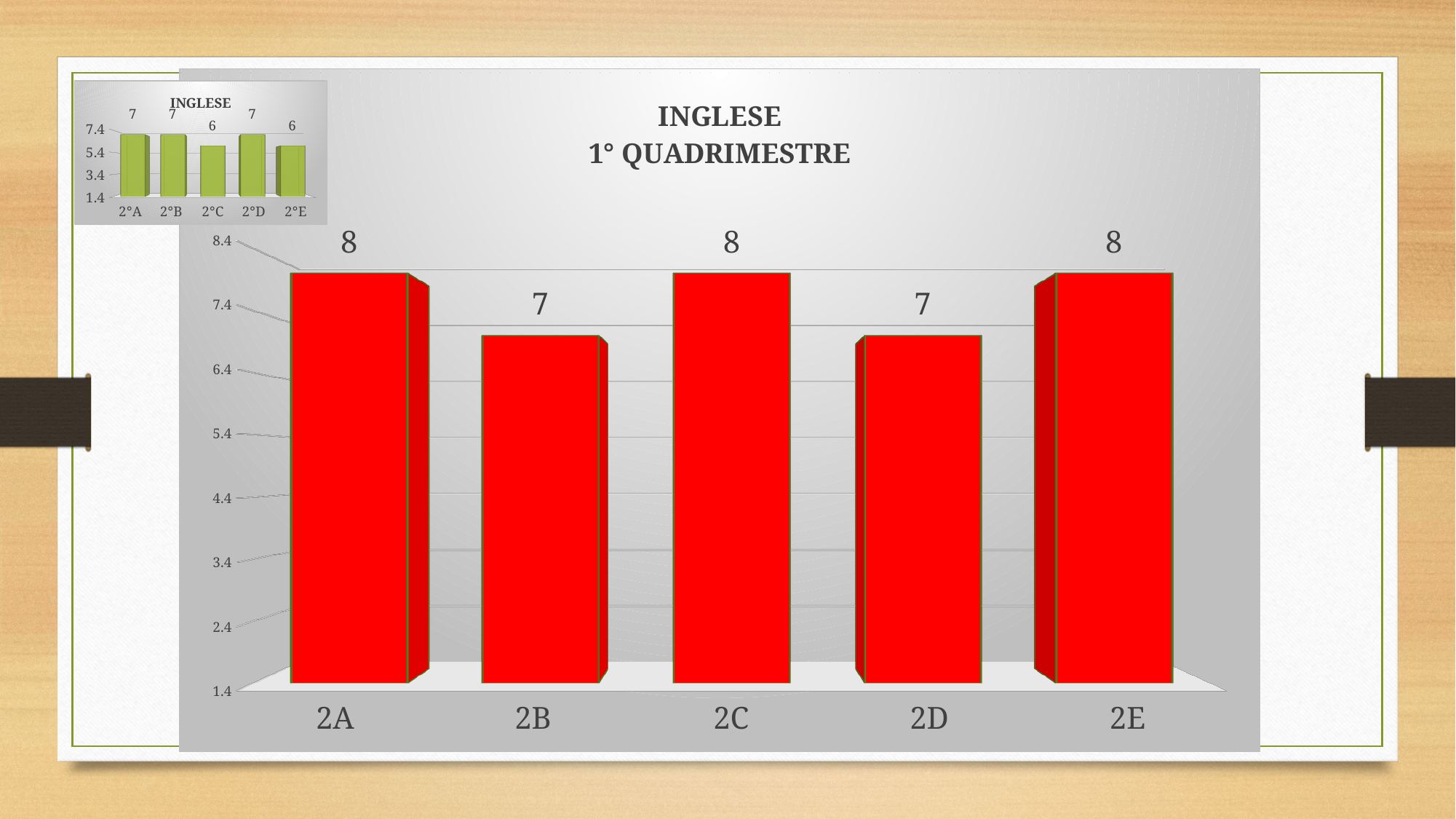
In the large chart titled INGLESE 1° QUADRIMESTRE, what is the value for 2E? 8 In the large chart titled INGLESE 1° QUADRIMESTRE, what is the value for 2D? 7 What kind of chart is the large chart titled INGLESE 1° QUADRIMESTRE? bar chart In the large chart titled INGLESE 1° QUADRIMESTRE, what is the value for 2B? 7 In the small chart titled INGLESE in the top-left corner, what is the value for 2°A? 7 What colour are the bars in the large chart titled INGLESE 1° QUADRIMESTRE? red In the large chart titled INGLESE 1° QUADRIMESTRE, how many categories are shown on the x axis? 5 In the large chart titled INGLESE 1° QUADRIMESTRE, which is larger, the value for 2C or the value for 2D? 2C In the small chart titled INGLESE in the top-left corner, which is larger, the value for 2°D or the value for 2°E? 2°D In the small chart titled INGLESE in the top-left corner, what is the value for 2°C? 6 In the small chart titled INGLESE in the top-left corner, what is the difference between the values for 2°B and 2°C? 1 In the large chart titled INGLESE 1° QUADRIMESTRE, what is the difference between the values for 2A and 2B? 1